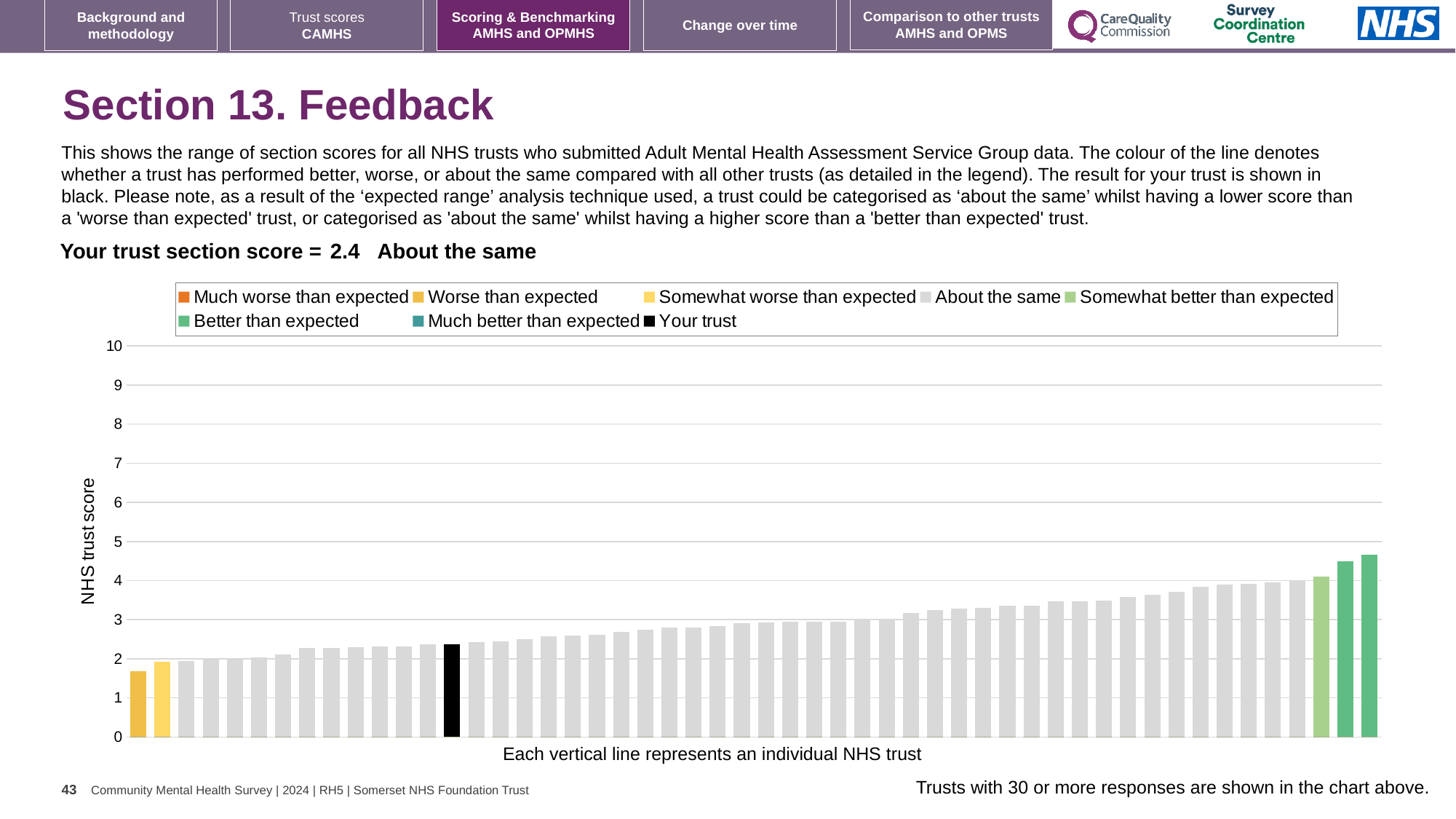
Is the value of the tallest bar in the chart greater or less than 5? less How many entries does the chart legend list? 8 Is the value for your trust (the black bar) greater or less than 2? greater Is the value of the shortest bar (the leftmost bar) greater or less than 2? less What kind of chart is shown on the slide? bar chart According to the legend, what colour is used for 'Your trust'? black What is the section score for your trust shown on the slide? 2.4 Do the bar values rise or fall from left to right across the chart? rise What is the title of the vertical axis of the chart? NHS trust score